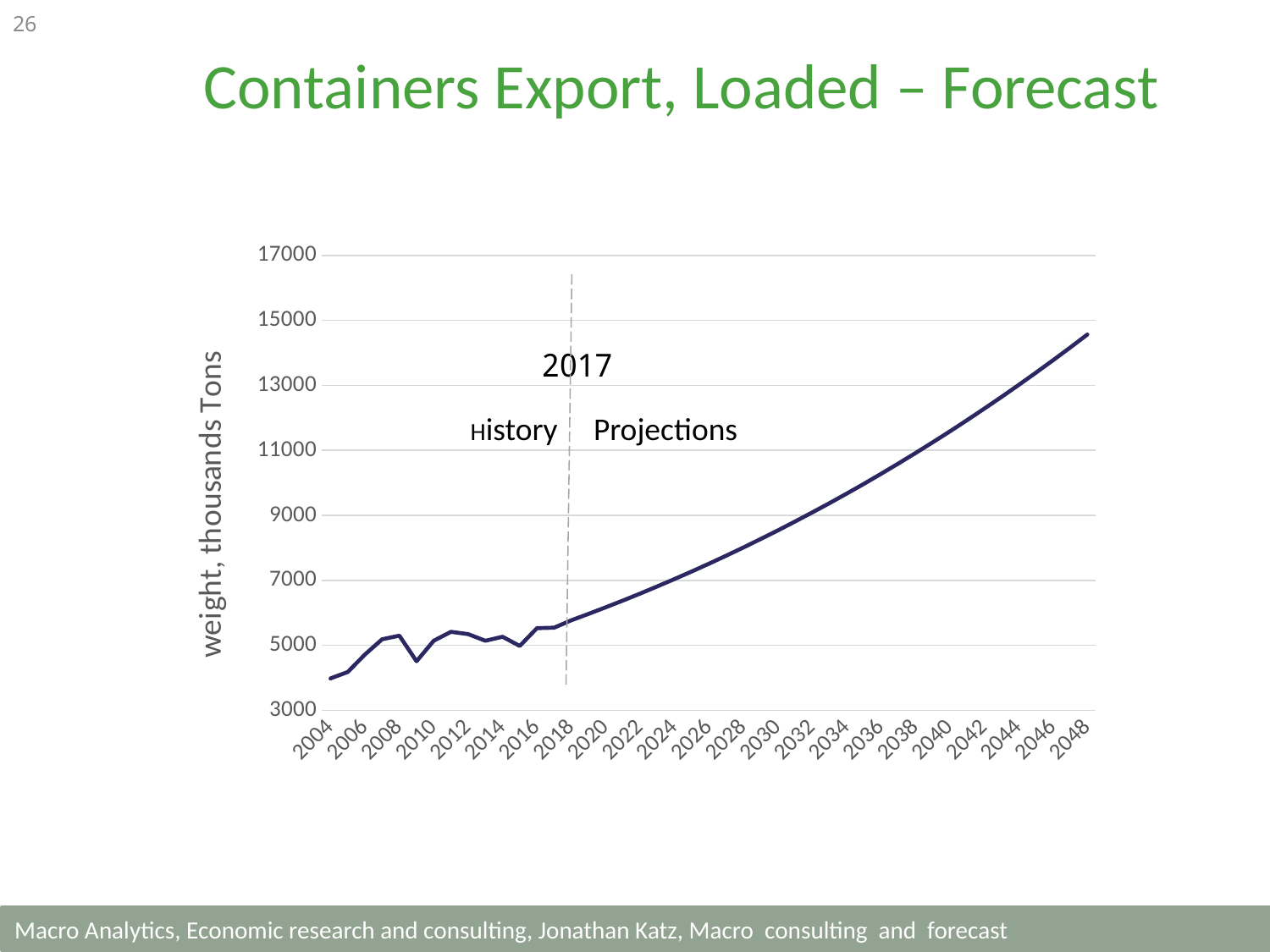
Which year has the highest value on the chart? 2048 Is the value for 2030 greater or less than 7000? greater What kind of chart is shown on the slide? line chart Is the value for 2036 greater or less than 9000? greater Is the value for 2004 greater or less than 5000? less What is the title of the chart? Containers Export, Loaded – Forecast What is the label on the vertical axis of the chart? weight, thousands Tons Which year has the lowest value on the chart? 2004 Which year has the larger value, 2004 or 2048? 2048 Do the values generally rise or fall from 2018 to 2048? rise